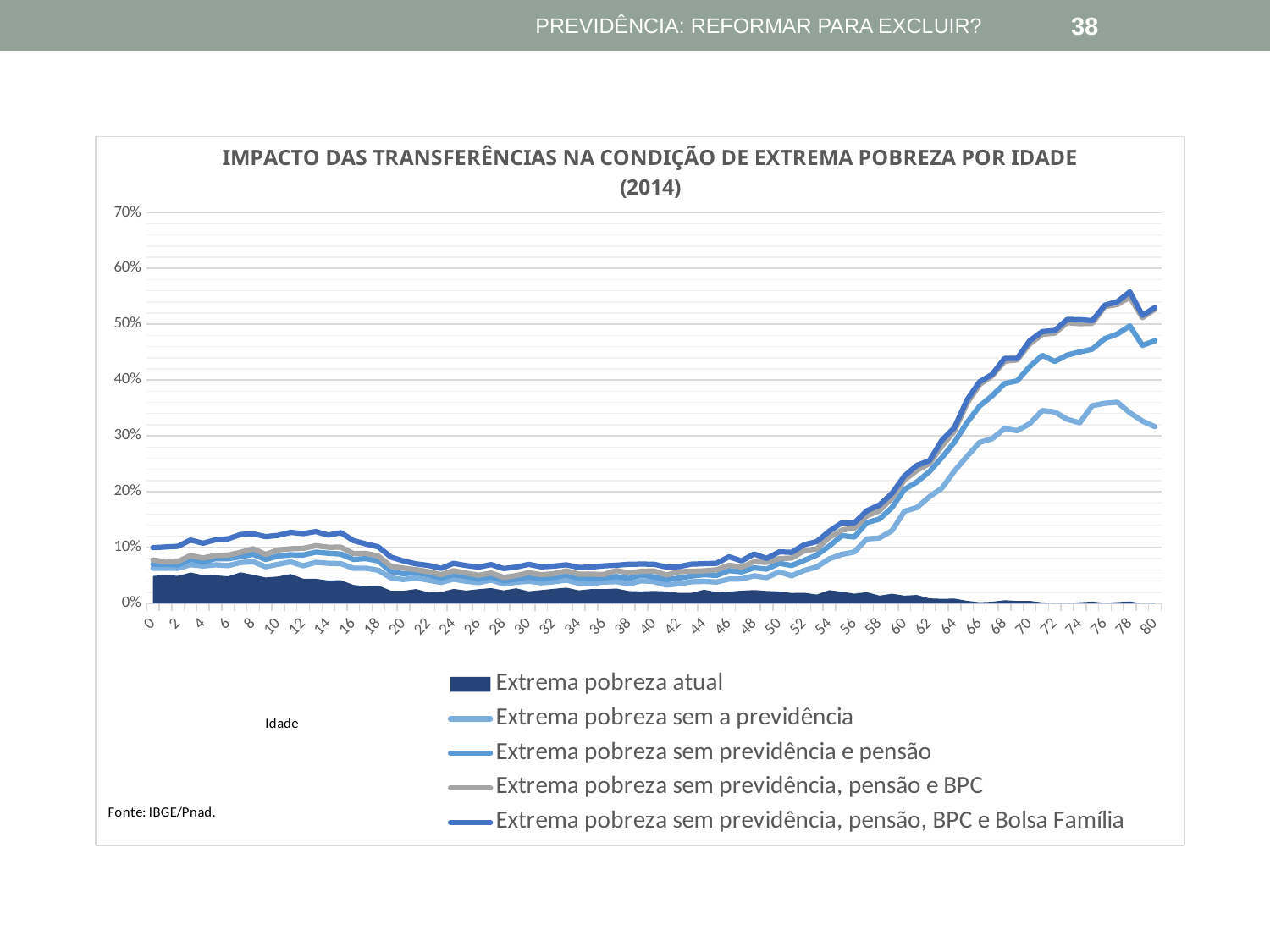
How many series does the legend list? 5 What kind of chart is shown on the slide? combination area and line chart Does 'Extrema pobreza sem a previdência' rise or fall between ages 60 and 70? rise Is the value for 'Extrema pobreza sem a previdência' at age 76 greater or less than 30%? greater What source is cited for the chart? IBGE/Pnad Is the value for 'Extrema pobreza sem previdência, pensão, BPC e Bolsa Família' at age 78 greater or less than 50%? greater Is the value for 'Extrema pobreza atual' at age 0 greater or less than 10%? less At age 70, which is higher: 'Extrema pobreza atual' or 'Extrema pobreza sem a previdência'? Extrema pobreza sem a previdência At age 80, which is higher: 'Extrema pobreza sem a previdência' or 'Extrema pobreza sem previdência e pensão'? Extrema pobreza sem previdência e pensão Does 'Extrema pobreza atual' rise or fall between ages 50 and 80? fall What year is given in the chart title? 2014 Which series has the lowest value at age 70? Extrema pobreza atual